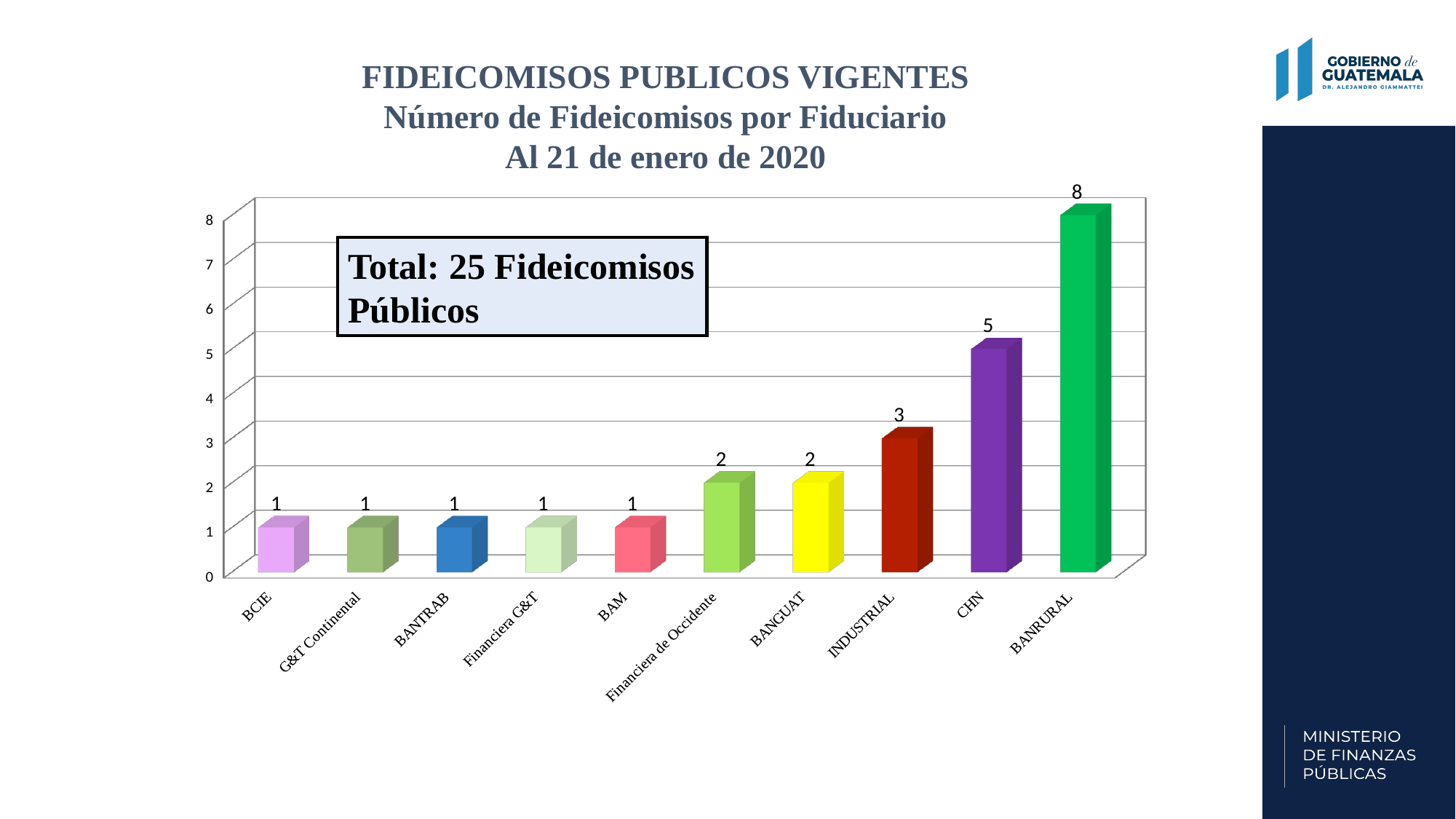
What total number of fideicomisos públicos is stated in the box on the chart? 25 Which fiduciario has the highest number of fideicomisos? BANRURAL What is the value shown for CHN? 5 How many fiduciarios have a value of 1? 5 How many fiduciarios are shown on the x axis? 10 Which is larger, the value for INDUSTRIAL or the value for Financiera de Occidente? INDUSTRIAL What kind of chart is shown on the slide? Bar chart What is the difference between the values for BANRURAL and CHN? 3 What is the value shown for INDUSTRIAL? 3 Do the values rise or fall from left to right along the x axis? Rise What is the value shown for BANGUAT? 2 How many fideicomisos does BANRURAL have? 8